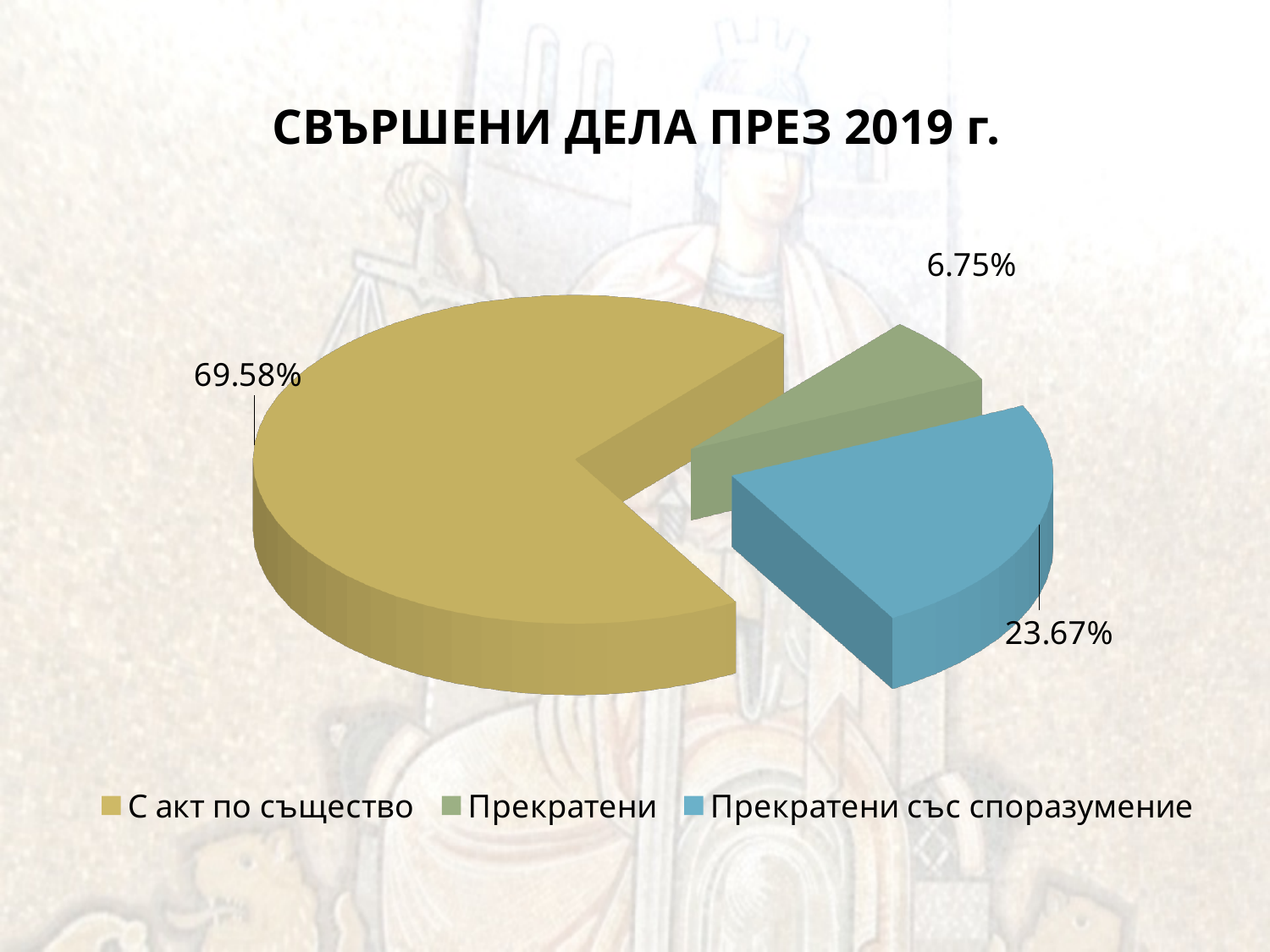
Which category has the smallest slice of the pie? Прекратени What colour is the slice for "Прекратени със споразумение"? Blue What share of the pie is labelled for "С акт по същество"? 69.58% What is the title of the chart? СВЪРШЕНИ ДЕЛА ПРЕЗ 2019 г. What share of the pie is labelled for "Прекратени"? 6.75% How many slices does the pie chart have? 3 What kind of chart is shown on the slide? Pie chart What is the difference in percentage points between the shares for "С акт по същество" and "Прекратени със споразумение"? 45.91 Which is larger: the share for "Прекратени" or the share for "Прекратени със споразумение"? Прекратени със споразумение How many entries does the legend list? 3 Which category has the largest slice of the pie? С акт по същество What share of the pie is labelled for "Прекратени със споразумение"? 23.67%